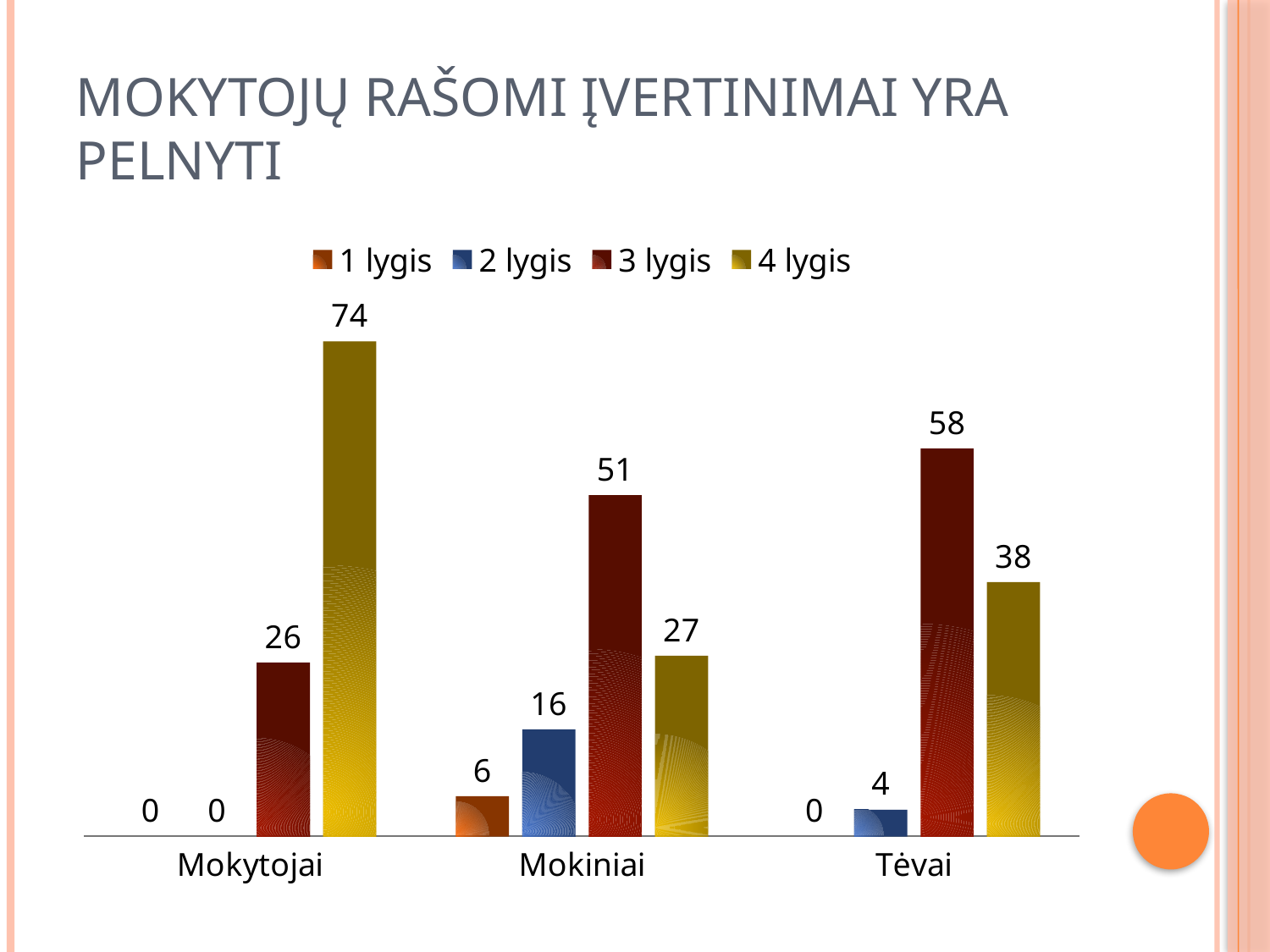
How many series does the legend list? 4 How many categories are shown on the x axis? 3 What is the value for 2 lygis in the Mokiniai category? 16 What is the value for 4 lygis in the Mokytojai category? 74 Which category has the lowest value for 3 lygis? Mokytojai What is the value for 1 lygis in the Mokiniai category? 6 Which is larger in the Mokiniai category: 3 lygis or 4 lygis? 3 lygis What is the value for 3 lygis in the Tėvai category? 58 Which category has the highest value for 4 lygis? Mokytojai What is the title of the slide? Mokytojų rašomi įvertinimai yra pelnyti What kind of chart is shown on the slide? Bar chart What is the difference between the 3 lygis and 4 lygis values in the Tėvai category? 20